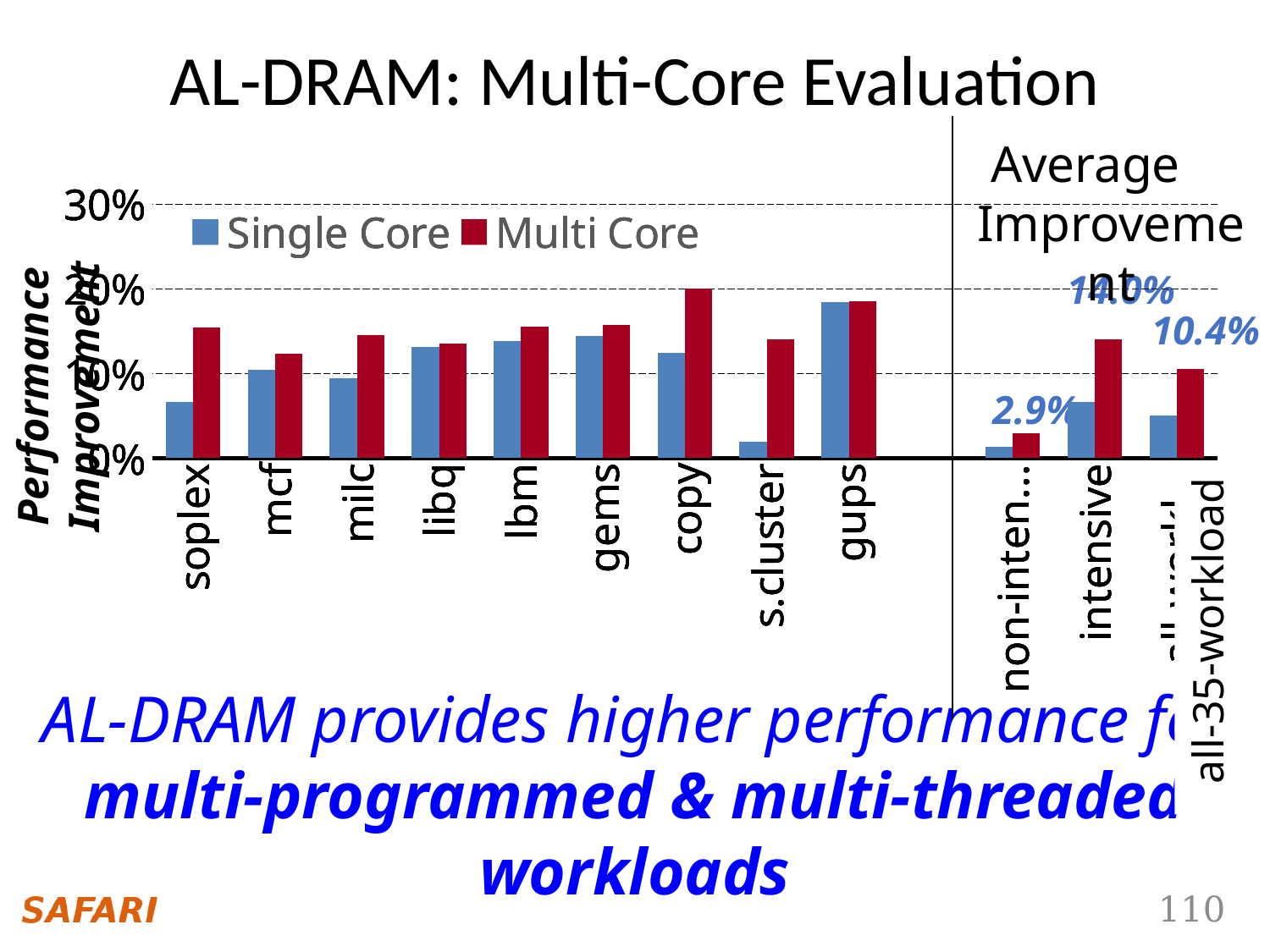
Is the Single Core value for soplex greater or less than 10%? less What kind of chart is shown on the slide? bar chart How many series does the legend list? 2 Is the Single Core value for s.cluster greater or less than 10%? less What annotated value is printed above the intensive category in the Average Improvement section? 14.0% Which is larger: the Single Core value for gups or the Single Core value for soplex? gups How many benchmark categories are plotted to the left of the vertical divider line? 9 Is the Multi Core value for gups greater or less than 10%? greater Which benchmark has the highest Single Core performance improvement? gups For s.cluster, which is larger: the Single Core or the Multi Core bar? Multi Core Among the nine benchmarks left of the divider, which has the lowest Single Core performance improvement? s.cluster What are the two series named in the legend? Single Core and Multi Core